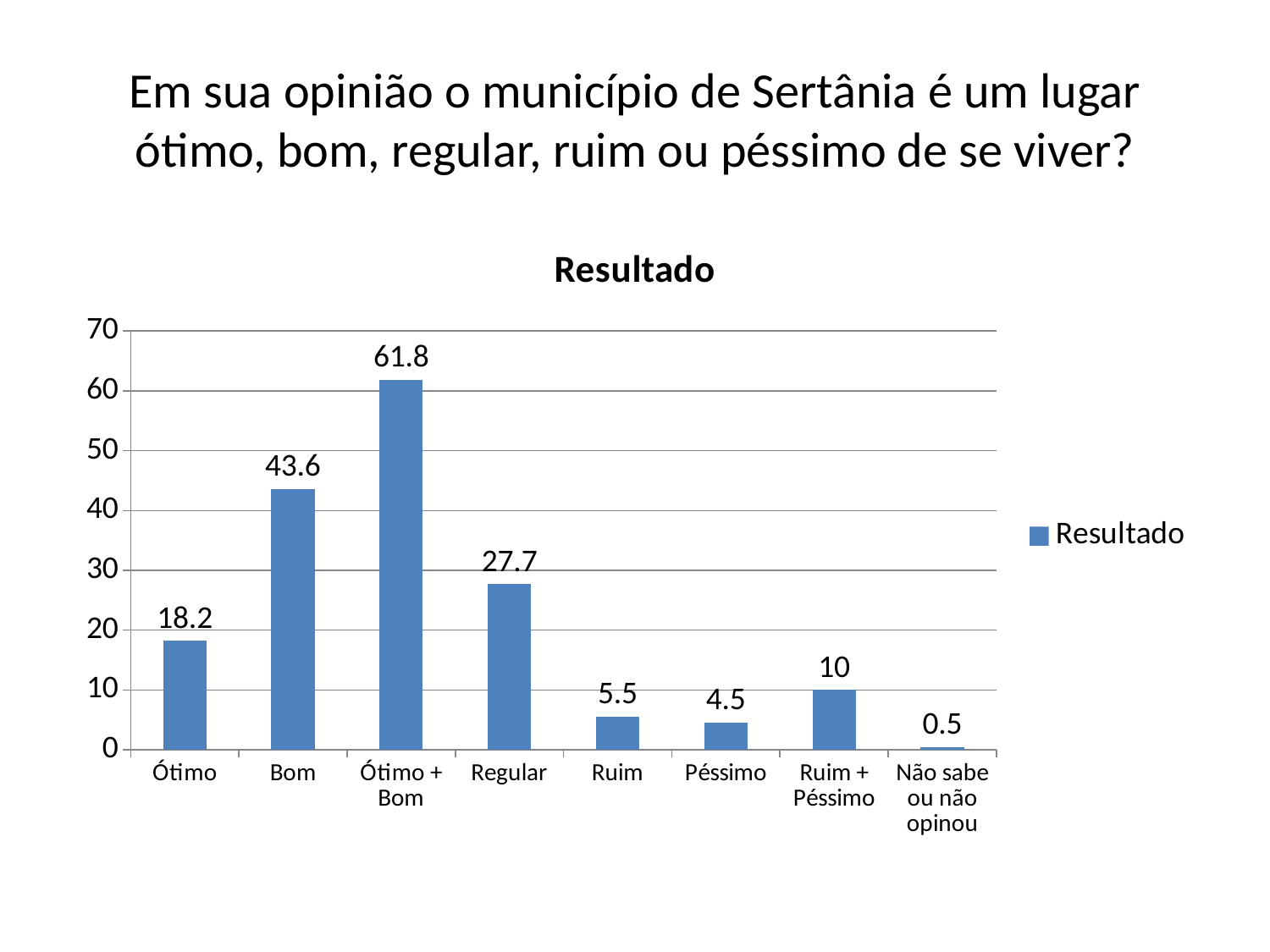
What kind of chart is shown? bar chart Which is larger, the value for Ruim or the value for Péssimo? Ruim Which category has the lowest value? Não sabe ou não opinou How many series does the legend list? 1 Which category has the highest value? Ótimo + Bom What is the value for Não sabe ou não opinou? 0.5 What is the value for Regular? 27.7 What is the difference between the values for Bom and Ótimo? 25.4 How many categories are shown on the x axis? 8 Is the value for Ruim + Péssimo greater or less than 20? less What is the value for Ótimo? 18.2 What is the title of the chart? Resultado